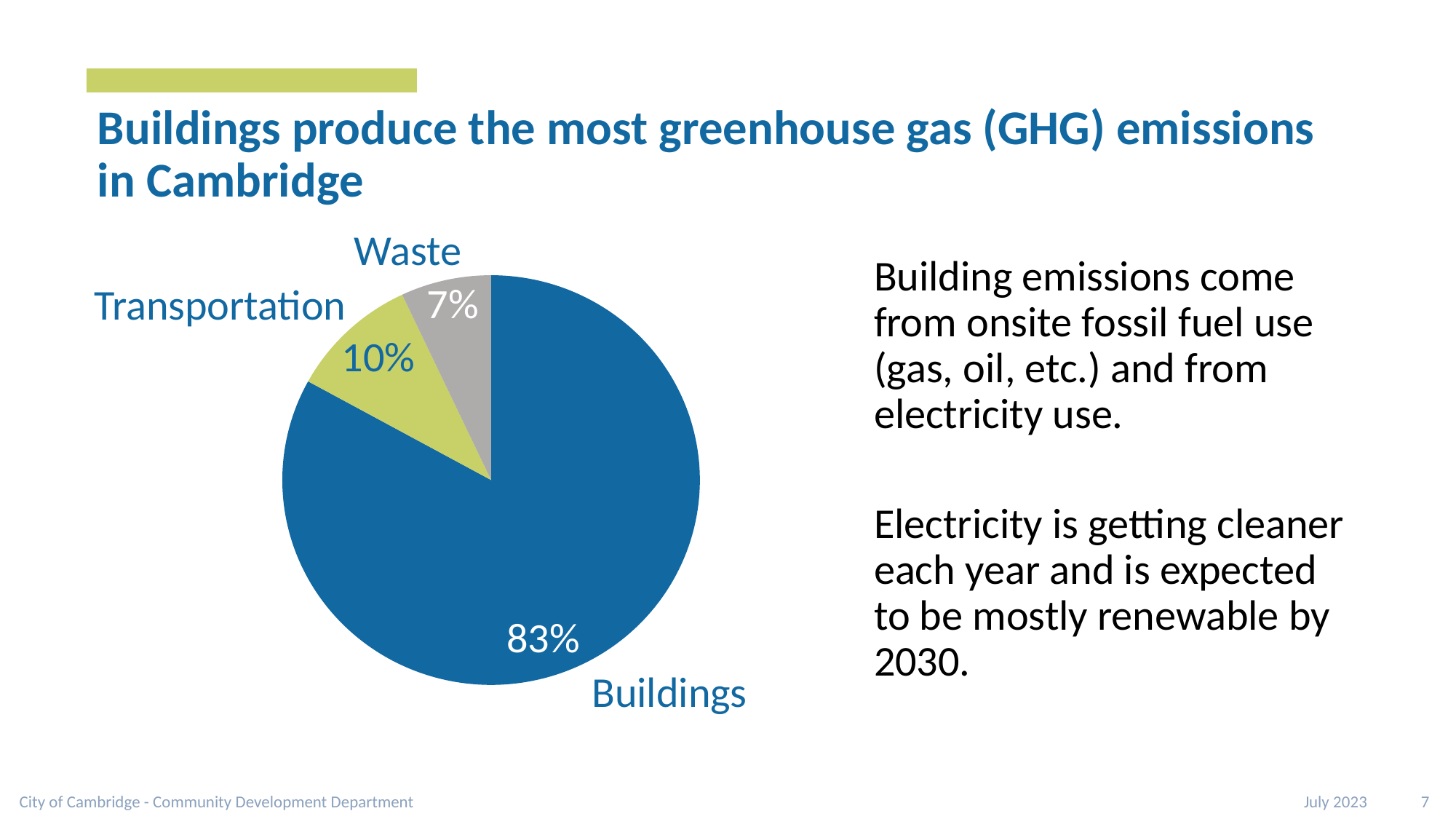
What share of GHG emissions comes from Waste? 7% What share of GHG emissions comes from Transportation? 10% What colour is the Buildings slice? Blue Which category has the largest share of emissions? Buildings What share of GHG emissions comes from Buildings? 83% How many categories are shown in the pie chart? 3 What colour is the Waste slice? Grey Which category has the smallest share of emissions? Waste Which is larger, the share for Transportation or the share for Waste? Transportation What kind of chart is shown on the slide? Pie chart What is the difference in percentage points between the Transportation and Waste shares? 3 What is the difference in percentage points between the Buildings and Transportation shares? 73